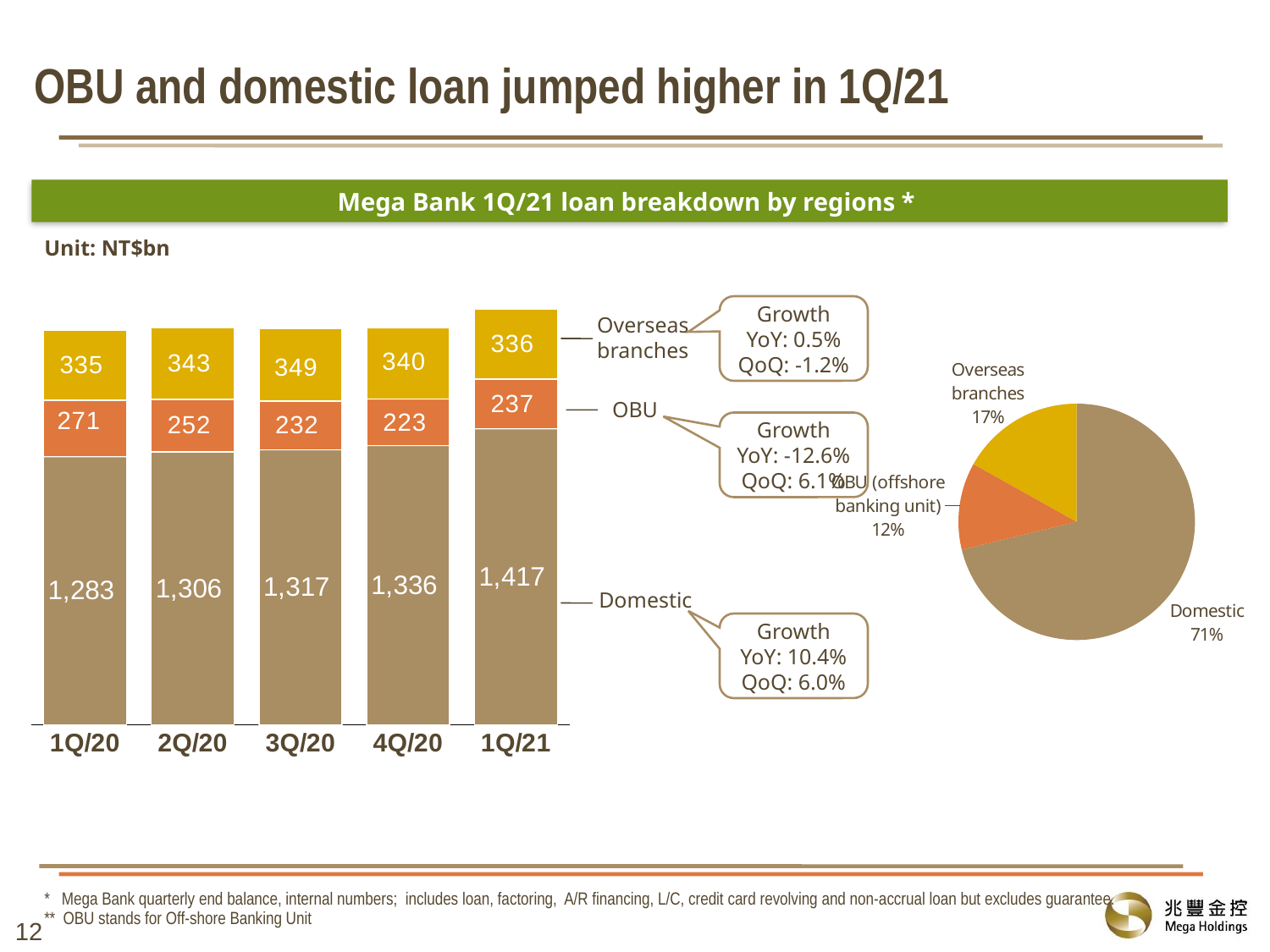
In the stacked bar chart, which quarter has the highest Domestic loan value? 1Q/21 In the stacked bar chart, what is the difference between the Domestic values for 1Q/21 and 4Q/20? 81 In the pie chart, which segment is the smallest? OBU (offshore banking unit) In the stacked bar chart, what is the Domestic loan value for 1Q/21? 1,417 In the pie chart, what share of loans is Domestic? 71% In the stacked bar chart, which is larger: the OBU value for 1Q/20 or for 1Q/21? 1Q/20 In the stacked bar chart, what is the OBU value for 4Q/20? 223 In the stacked bar chart, which quarter has the lowest OBU value? 4Q/20 In the stacked bar chart, does the Domestic loan value rise or fall from 1Q/20 to 1Q/21? rise How many quarters are shown on the x axis of the stacked bar chart? 5 What is the total of the stacked bar for 1Q/21? 1,990 In the stacked bar chart, what is the Overseas branches value for 3Q/20? 349